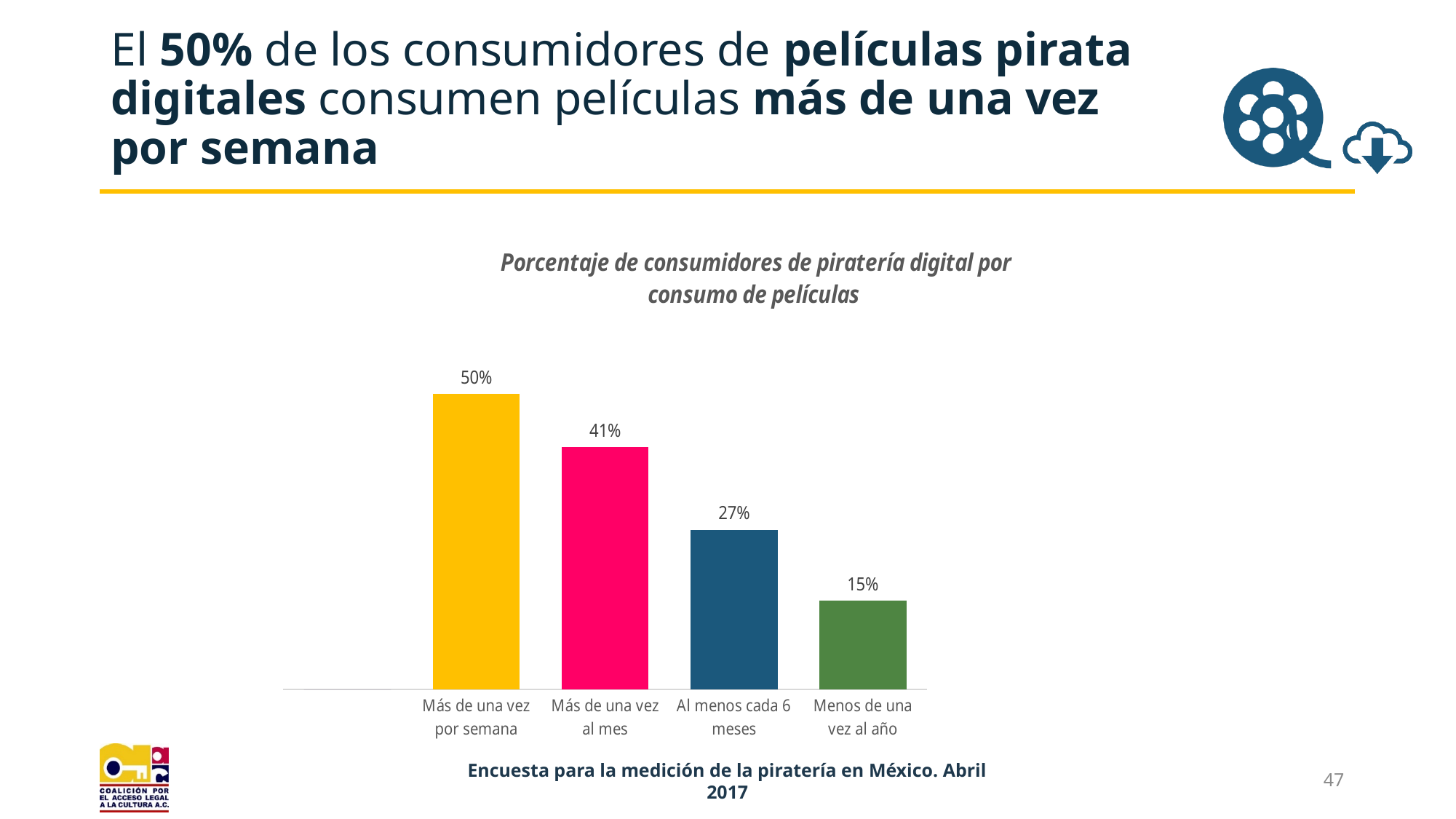
What is the value for "Menos de una vez al año"? 15% What kind of chart is shown on the slide? Bar chart What is the value for "Al menos cada 6 meses"? 27% Which category has the highest value? Más de una vez por semana What is the difference between the values for "Más de una vez por semana" and "Más de una vez al mes"? 9% Which is larger, the value for "Más de una vez al mes" or the value for "Al menos cada 6 meses"? Más de una vez al mes What is the value for "Más de una vez por semana"? 50% How many categories are shown in the chart? 4 What is the value for "Más de una vez al mes"? 41% Which category has the lowest value? Menos de una vez al año Do the values rise or fall from left to right along the x axis? Fall What is the difference between the values for "Al menos cada 6 meses" and "Menos de una vez al año"? 12%